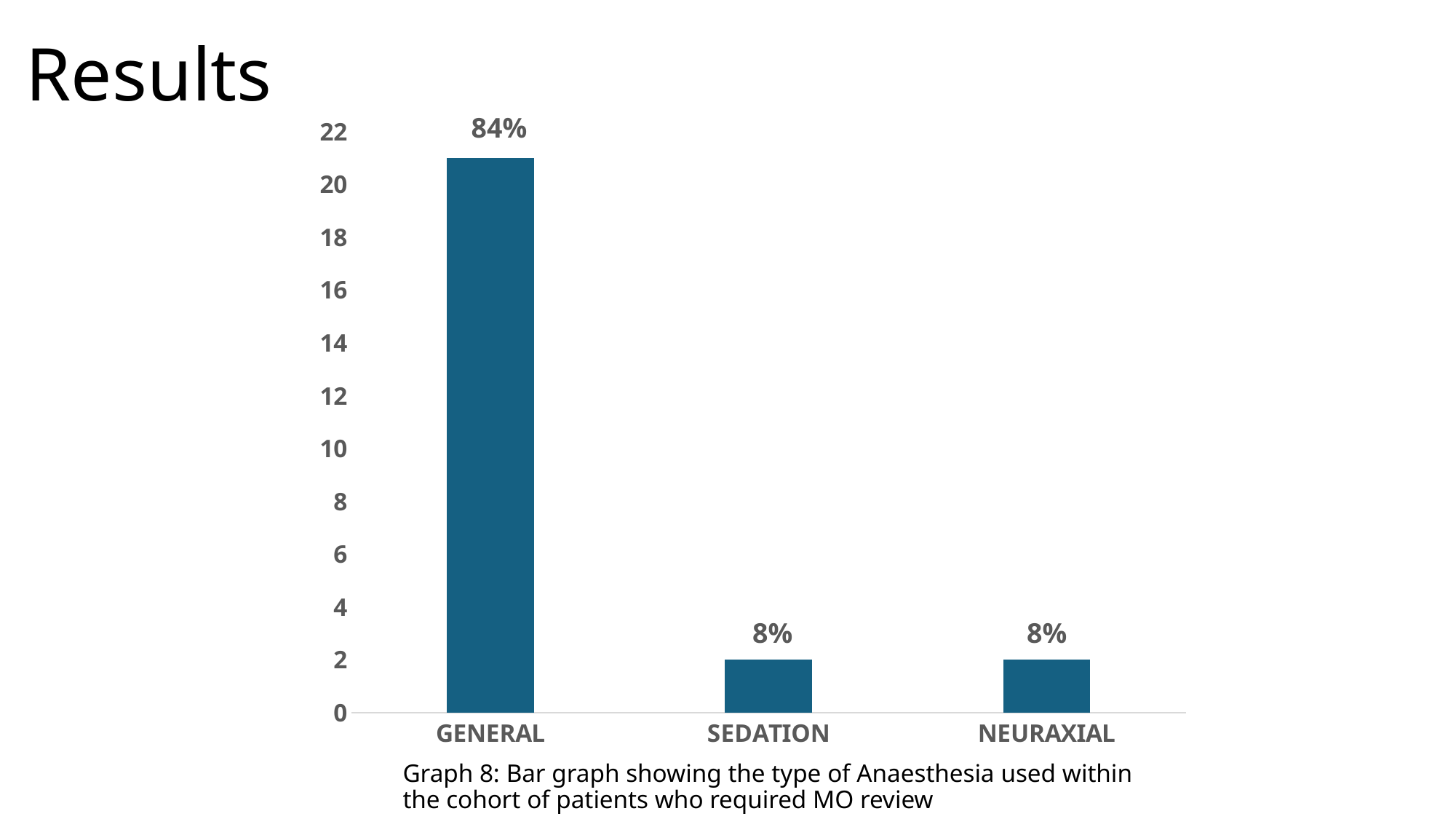
What data label is shown above the SEDATION bar? 8% Is the value for GENERAL on the vertical axis greater or less than 20? greater How many categories are shown on the x axis? 3 According to the caption, what does Graph 8 show? The type of Anaesthesia used within the cohort of patients who required MO review What is the highest tick value shown on the vertical axis? 22 What is the difference between the percentage labels for GENERAL and SEDATION? 76% Is the value for SEDATION on the vertical axis greater or less than 4? less Which is larger, the value for GENERAL or the value for NEURAXIAL? GENERAL What data label is shown above the NEURAXIAL bar? 8% What data label is shown above the GENERAL bar? 84% Which category has the highest bar? GENERAL What kind of chart is shown on the slide? Bar chart